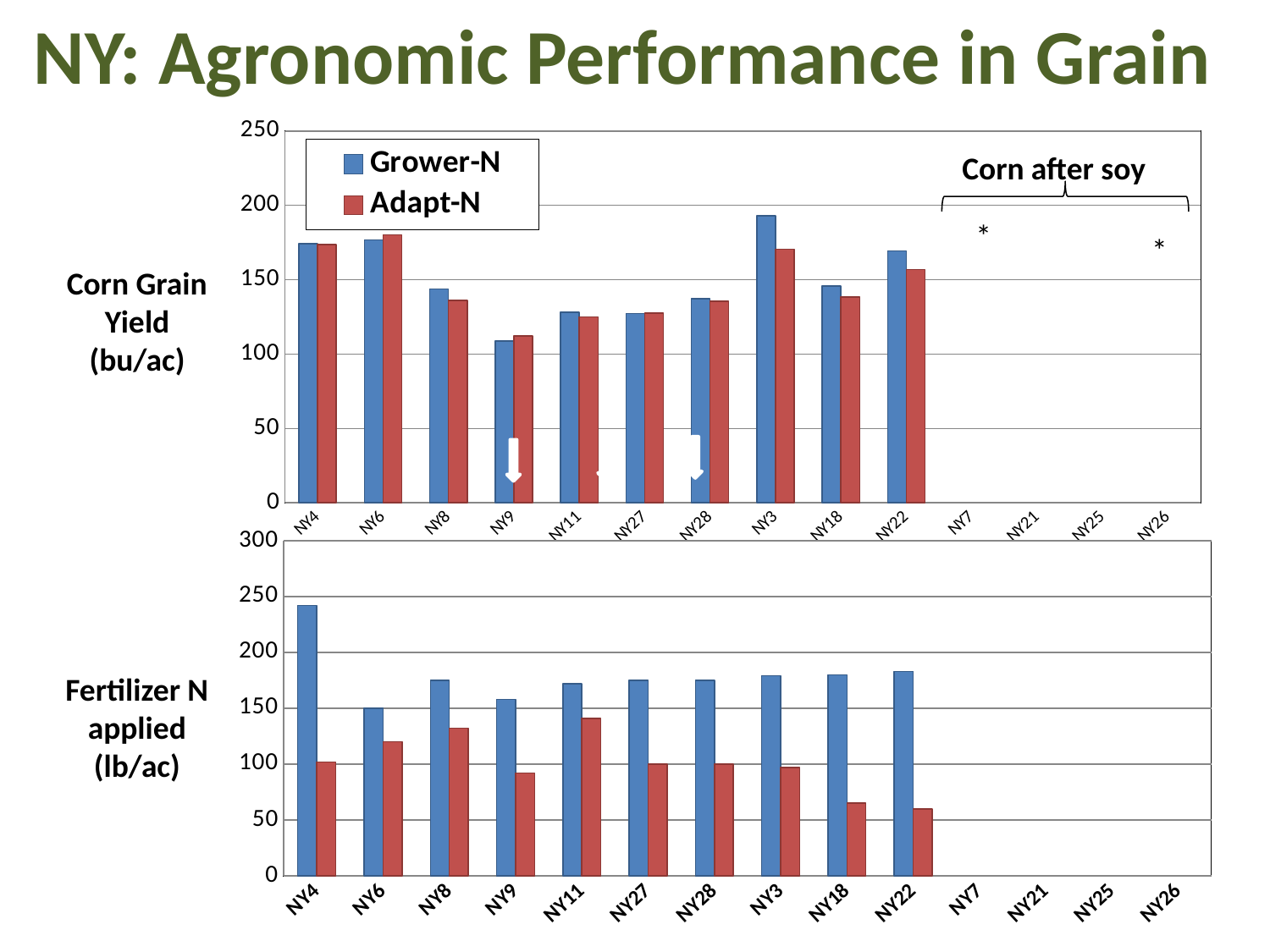
What kind of chart is the Corn Grain Yield chart at the top of the slide? bar chart In the Fertilizer N applied chart, which site has the highest Grower-N value? NY4 How many site labels appear along the x axis of the Fertilizer N applied chart? 14 In the Fertilizer N applied chart, is the Adapt-N value for NY22 greater or less than 100? less In the Corn Grain Yield chart, is the Grower-N value for NY3 greater or less than 150? greater How many series does the legend on the Corn Grain Yield chart list? 2 In the Fertilizer N applied chart, which is larger for NY18: Grower-N or Adapt-N? Grower-N In the Corn Grain Yield chart, which site has the highest Grower-N yield? NY3 What are the two series named in the legend of the Corn Grain Yield chart? Grower-N and Adapt-N In the Corn Grain Yield chart, which site has the lowest Grower-N yield? NY9 In the Corn Grain Yield chart, which sites are grouped under the label 'Corn after soy'? NY7, NY21, NY25, NY26 In the Fertilizer N applied chart, is the Grower-N value for NY4 greater or less than 200? greater